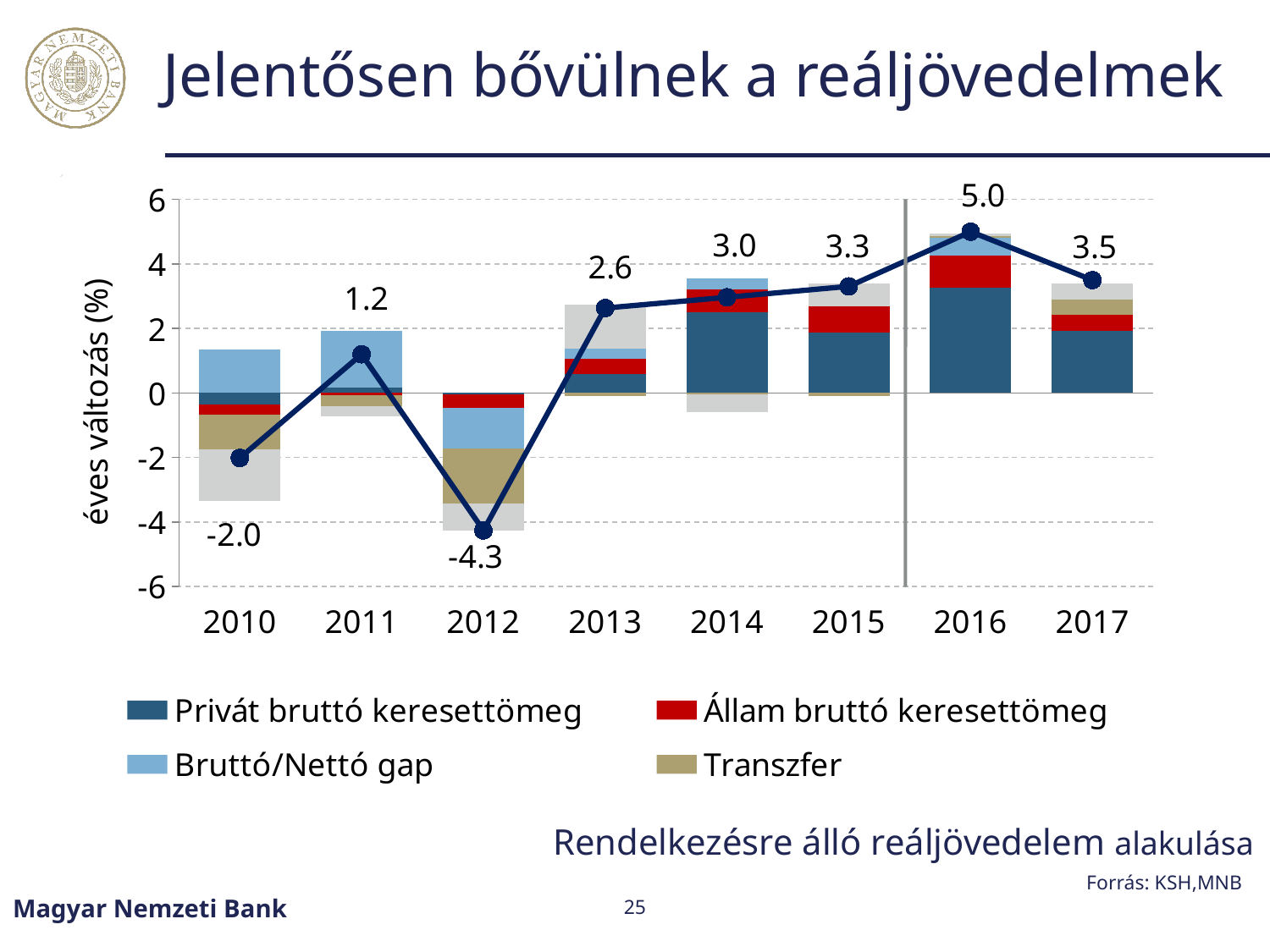
Which year has the highest labelled line value? 2016 How many series does the legend list? 4 Which year has the lowest labelled line value? 2012 What is the labelled value of the line for 2010? -2.0 What is the label of the y axis? éves változás (%) What is the labelled value of the line for 2016? 5.0 Which year has the larger labelled line value, 2014 or 2015? 2015 What is the labelled value of the line for 2012? -4.3 What is the difference between the labelled line values for 2016 and 2017? 1.5 Does the labelled line value rise or fall from 2012 to 2016? rise What is the labelled value of the line for 2013? 2.6 How many years are shown on the x axis? 8